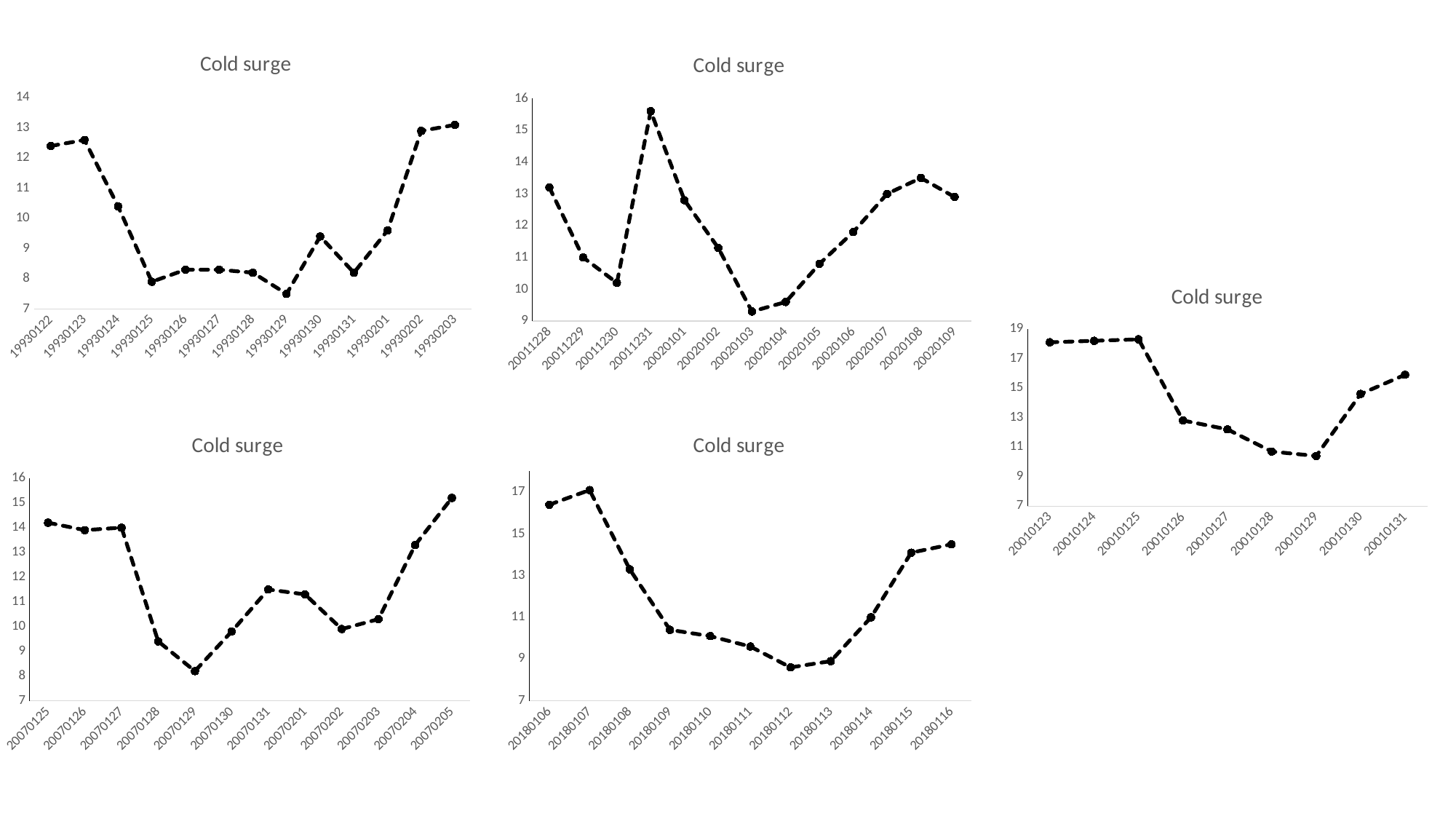
In the top-middle chart (dates starting 20011228), is the value for 20011231 greater or less than 15? greater In the bottom-left chart (dates starting 20070125), which date has the lowest value? 20070129 In the top-left chart (dates starting 19930122), is the value for 19930125 greater or less than 9? less In the top-left chart (dates starting 19930122), which date has the highest value? 19930203 In the top-left chart (dates starting 19930122), which date has the lowest value? 19930129 In the top-middle chart (dates starting 20011228), which date has the highest value? 20011231 What kind of chart is the bottom-middle chart (dates starting 20180106)? Line chart In the top-middle chart (dates starting 20011228), which date has the lowest value? 20020103 In the bottom-left chart (dates starting 20070125), is the value for 20070128 greater or less than 10? less In the right-hand chart (dates starting 20010123), how many data points are plotted? 9 In the bottom-middle chart (dates starting 20180106), which date has the highest value? 20180107